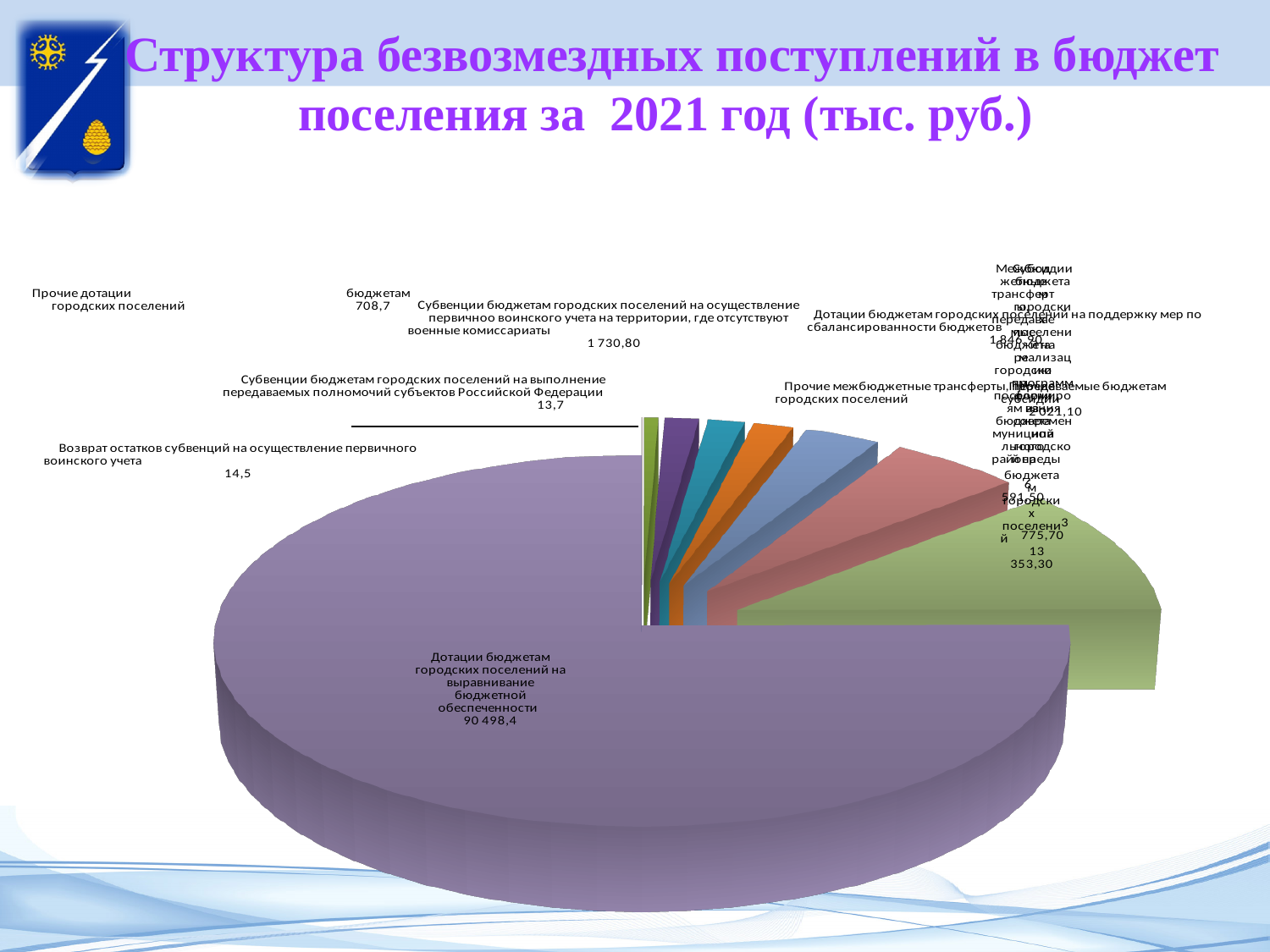
What is the title of the chart on the slide? Структура безвозмездных поступлений в бюджет поселения за 2021 год (тыс. руб.) What is the value for 'Субвенции бюджетам городских поселений на выполнение передаваемых полномочий субъектов Российской Федерации'? 13,7 What is the value for 'Дотации бюджетам городских поселений на выравнивание бюджетной обеспеченности'? 90 498,4 Which is larger: 'Возврат остатков субвенций на осуществление первичного воинского учета' or 'Субвенции бюджетам городских поселений на выполнение передаваемых полномочий субъектов Российской Федерации'? Возврат остатков субвенций на осуществление первичного воинского учета Which category has the largest slice of the pie? Дотации бюджетам городских поселений на выравнивание бюджетной обеспеченности What colour is the largest slice of the pie? purple What kind of chart is shown on the slide? pie chart What is the difference between 'Возврат остатков субвенций на осуществление первичного воинского учета' (14,5) and 'Субвенции бюджетам городских поселений на выполнение передаваемых полномочий субъектов Российской Федерации' (13,7)? 0,8 What is the value for 'Субвенции бюджетам городских поселений на осуществление первичноо воинского учета на территории, где отсутствуют военные комиссариаты'? 1 730,80 What is the value for 'Возврат остатков субвенций на осуществление первичного воинского учета'? 14,5 Which is larger: 'Субвенции бюджетам городских поселений на осуществление первичноо воинского учета на территории, где отсутствуют военные комиссариаты' or 'Субвенции бюджетам городских поселений на выполнение передаваемых полномочий субъектов Российской Федерации'? Субвенции бюджетам городских поселений на осуществление первичноо воинского учета на территории, где отсутствуют военные комиссариаты